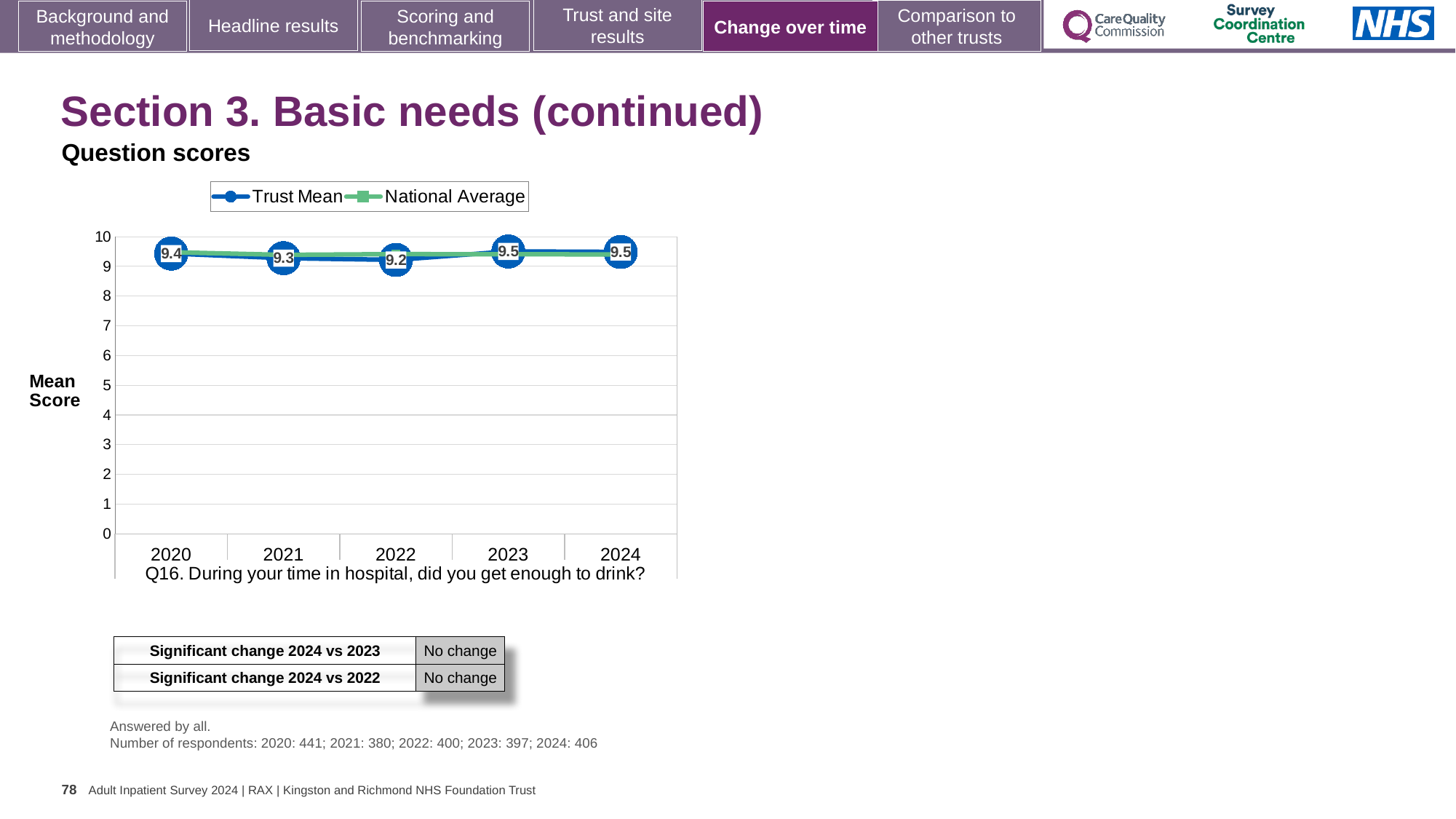
In which year is the Trust Mean score lowest? 2022 What is the Trust Mean score for 2022? 9.2 What is the Trust Mean score for 2020? 9.4 Which year has the higher Trust Mean score, 2020 or 2022? 2020 How many series does the chart legend list? 2 Does the Trust Mean score rise or fall from 2022 to 2023? Rise Is the National Average value for 2024 greater or less than 8? greater What is the difference between the Trust Mean scores for 2023 and 2022? 0.3 What kind of chart is shown on the slide? Line chart What is the label on the y axis of the chart? Mean Score What is the Trust Mean score for 2024? 9.5 How many years are shown on the x axis of the chart? 5